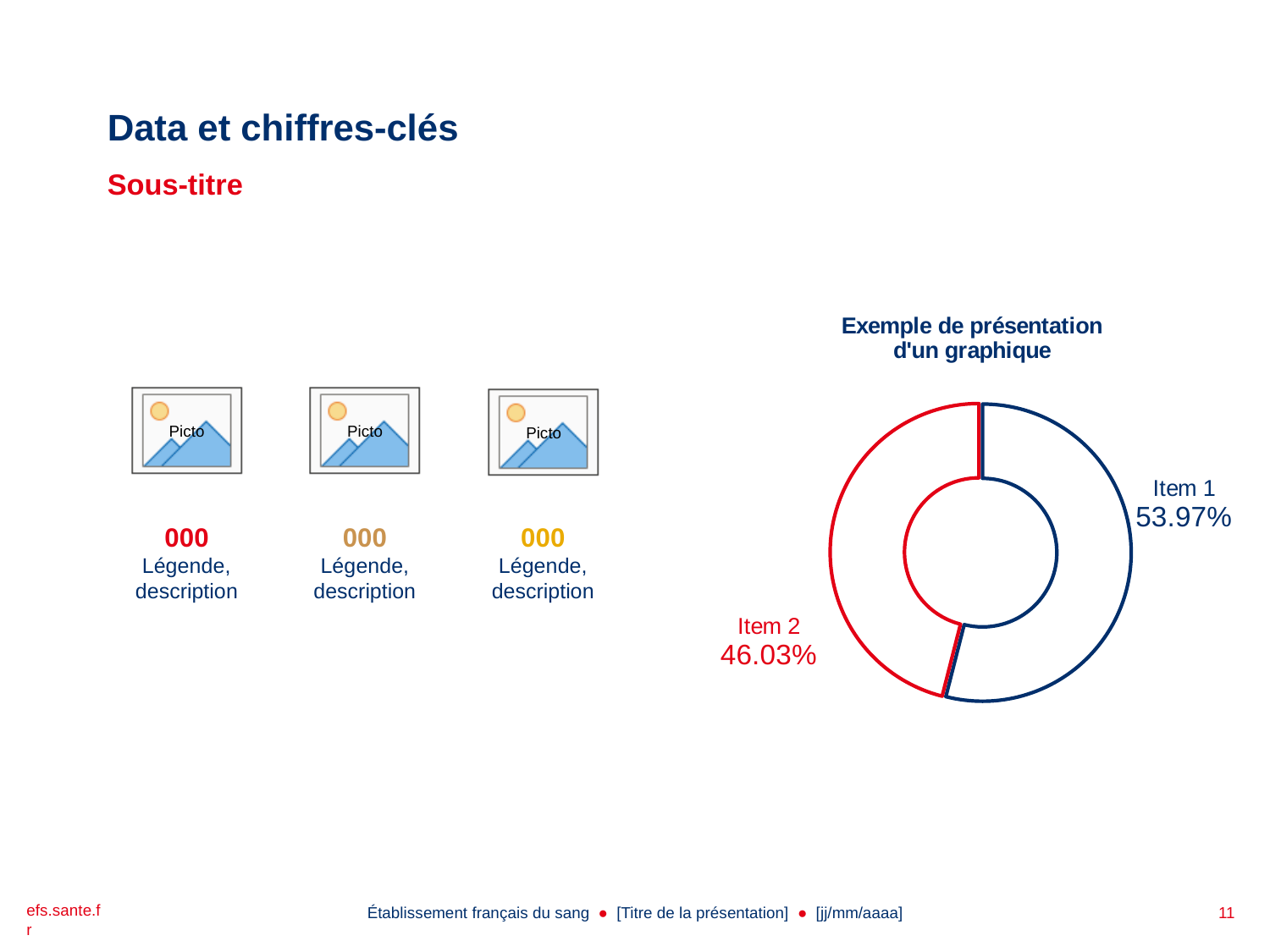
Which is larger, Item 1 or Item 2? Item 1 Is the value for Item 2 greater or less than 50%? less How many items are shown in the chart? 2 Which item has the largest share of the chart? Item 1 What colour is the outline of the Item 2 segment? Red What is the title of the chart? Exemple de présentation d'un graphique What is the difference in percentage points between Item 1 and Item 2? 7.94 What is the value shown for Item 1? 53.97% What is the value shown for Item 2? 46.03% What kind of chart is shown on the slide? Doughnut chart Which item has the smallest share of the chart? Item 2 Is the value for Item 1 greater or less than 50%? greater